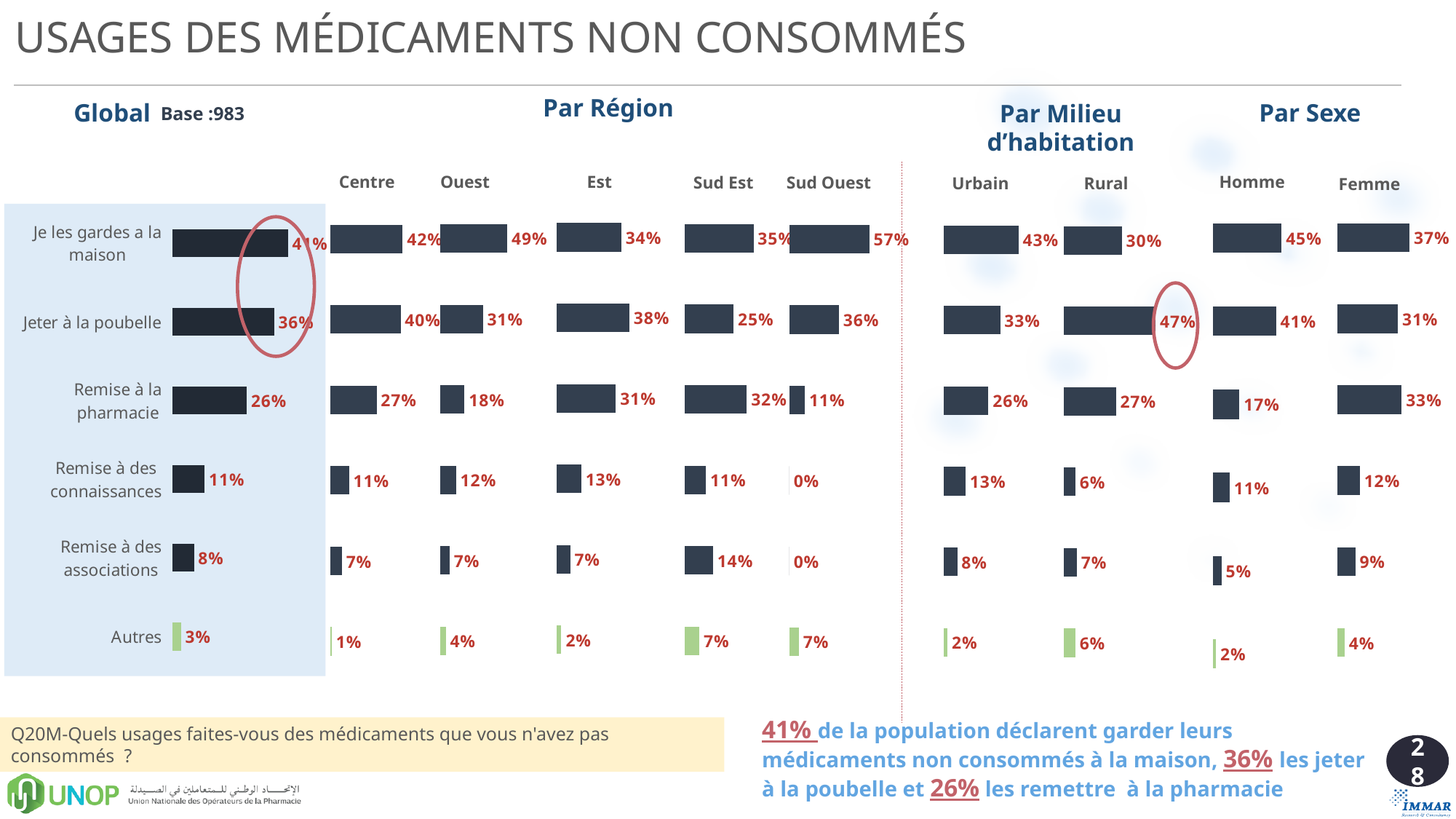
In the Sud Est chart under Par Région, what is the value for "Remise à des associations"? 14% In the Rural chart under Par Milieu d'habitation, what is the value for "Jeter à la poubelle"? 47% What is the difference between the Global values for "Je les gardes a la maison" and "Jeter à la poubelle"? 5% In the Global chart, what percentage is shown for "Je les gardes a la maison"? 41% What is the difference between the Urbain and Rural values for "Jeter à la poubelle"? 14% In the Global chart, which category has the highest value? Je les gardes a la maison What type of chart is used on this slide? Bar chart What is the base (sample size) shown next to the Global chart title? 983 For "Remise à la pharmacie", which is larger: the Homme value or the Femme value? Femme In the Global chart, which category has the lowest value? Autres In the Global chart, how many categories are plotted? 6 In the Sud Ouest chart under Par Région, what is the value for "Je les gardes a la maison"? 57%